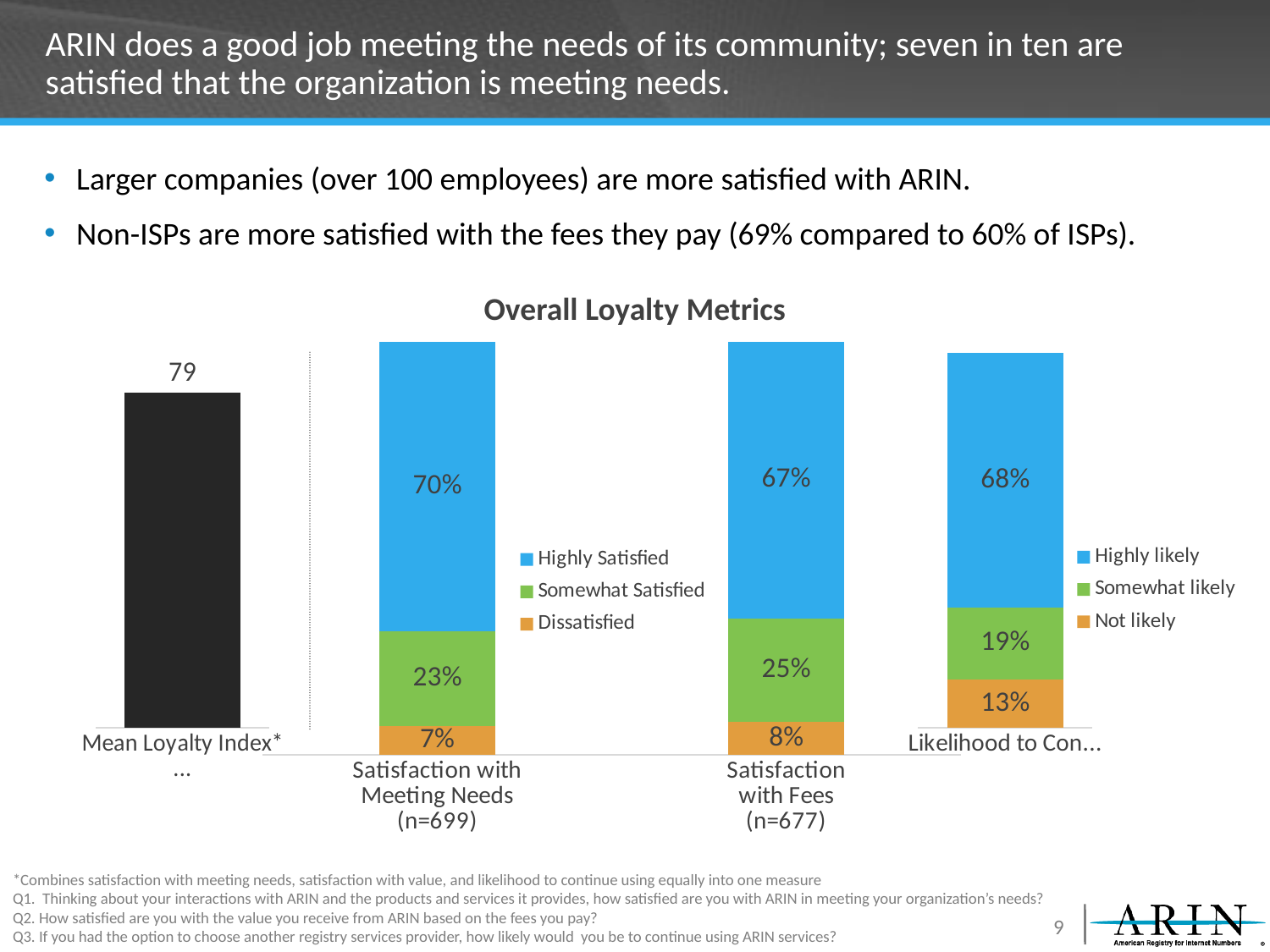
What is the sample size (n) shown for Satisfaction with Fees? 677 Which has a larger Highly Satisfied share: Satisfaction with Meeting Needs or Satisfaction with Fees? Satisfaction with Meeting Needs What is the title of the chart? Overall Loyalty Metrics In the rightmost stacked bar (Likelihood to Continue), what percentage are Not likely? 13% What type of chart is shown on the slide? Bar chart How many entries does the legend for the satisfaction bars list? 3 What percentage of respondents are Dissatisfied in the Satisfaction with Fees bar? 8% What percentage of respondents are Highly Satisfied with ARIN meeting needs? 70% What is the Mean Loyalty Index value shown on the chart? 79 What is the difference in percentage points between the Somewhat Satisfied share for Satisfaction with Fees and for Satisfaction with Meeting Needs? 2 percentage points Which of the three stacked bars has the smallest bottom (Dissatisfied / Not likely) segment? Satisfaction with Meeting Needs What is the total of the three segments in the Satisfaction with Fees bar? 100%